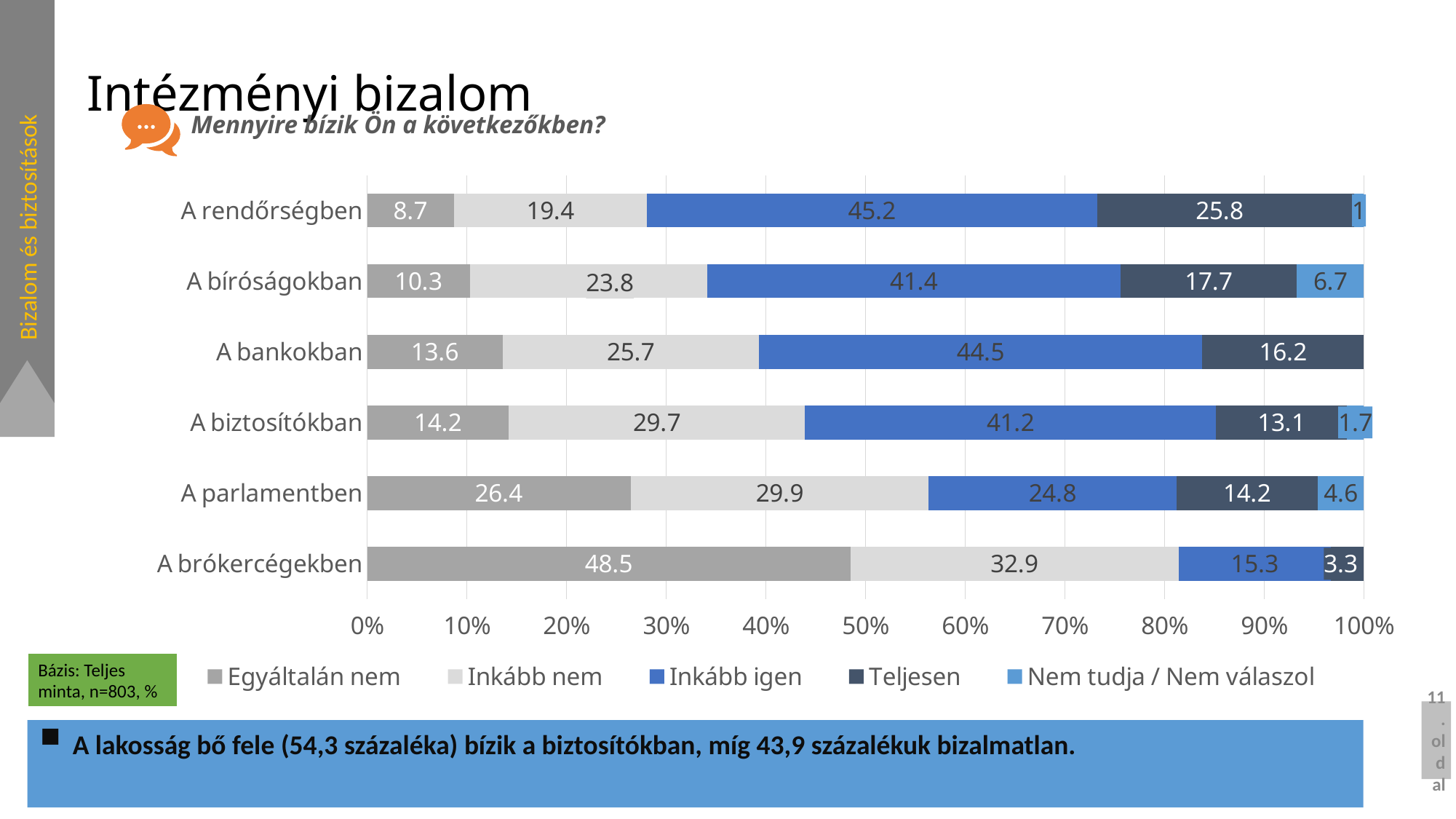
Which institution has the lowest 'Egyáltalán nem' value? A rendőrségben What is the 'Teljesen' value for A biztosítókban? 13.1 Which institution has the highest 'Teljesen' value? A rendőrségben What is the 'Egyáltalán nem' value for A brókercégekben? 48.5 What kind of chart is shown on the slide? Stacked bar chart How many series does the legend list? 5 How many institutions are shown on the chart? 6 What is the 'Inkább igen' value for A rendőrségben? 45.2 What is the difference between the 'Inkább nem' values for A parlamentben and A rendőrségben? 10.5 Which institution has the highest 'Egyáltalán nem' value? A brókercégekben Which is larger: the 'Inkább igen' value for A bankokban or for A bíróságokban? A bankokban What is the 'Nem tudja / Nem válaszol' value for A bíróságokban? 6.7